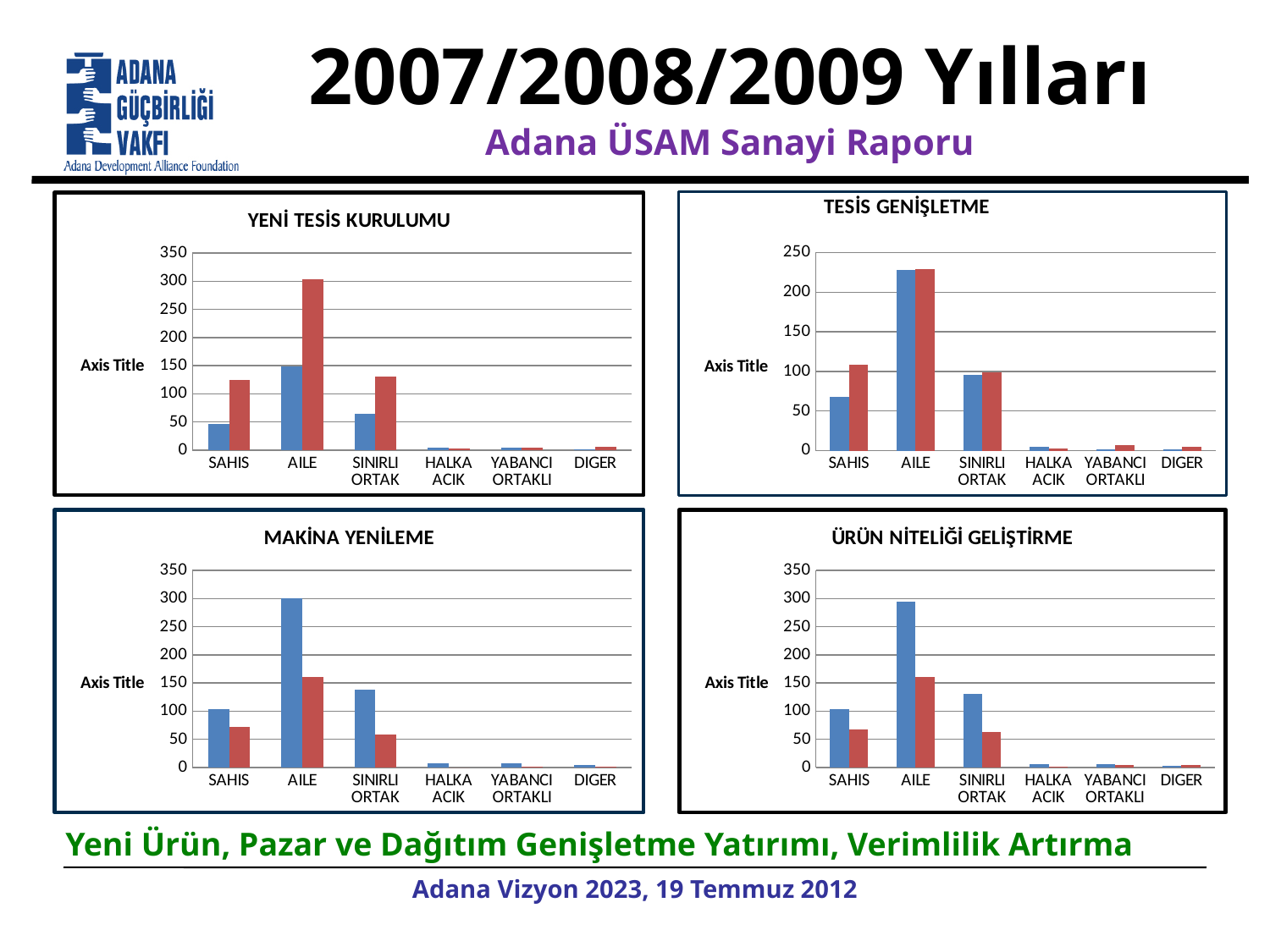
In the MAKİNA YENİLEME chart, for SAHIS, is the blue bar or the red bar taller? blue In the YENİ TESİS KURULUMU chart, for SINIRLI ORTAK, is the blue bar or the red bar taller? red In the TESİS GENİŞLETME chart, is the red bar for SINIRLI ORTAK greater or less than 150? less In the TESİS GENİŞLETME chart, is the blue bar for SAHIS greater or less than 100? less How many charts are shown on the slide? 4 What kind of chart is the YENİ TESİS KURULUMU chart? bar chart In the ÜRÜN NİTELİĞİ GELİŞTİRME chart, which category has the tallest red bar? AILE How many categories are shown on the x axis of the TESİS GENİŞLETME chart? 6 In the ÜRÜN NİTELİĞİ GELİŞTİRME chart, is the blue bar for AILE greater or less than 250? greater What is the highest tick value on the vertical axis of the MAKİNA YENİLEME chart? 350 In the MAKİNA YENİLEME chart, which category has the tallest blue bar? AILE